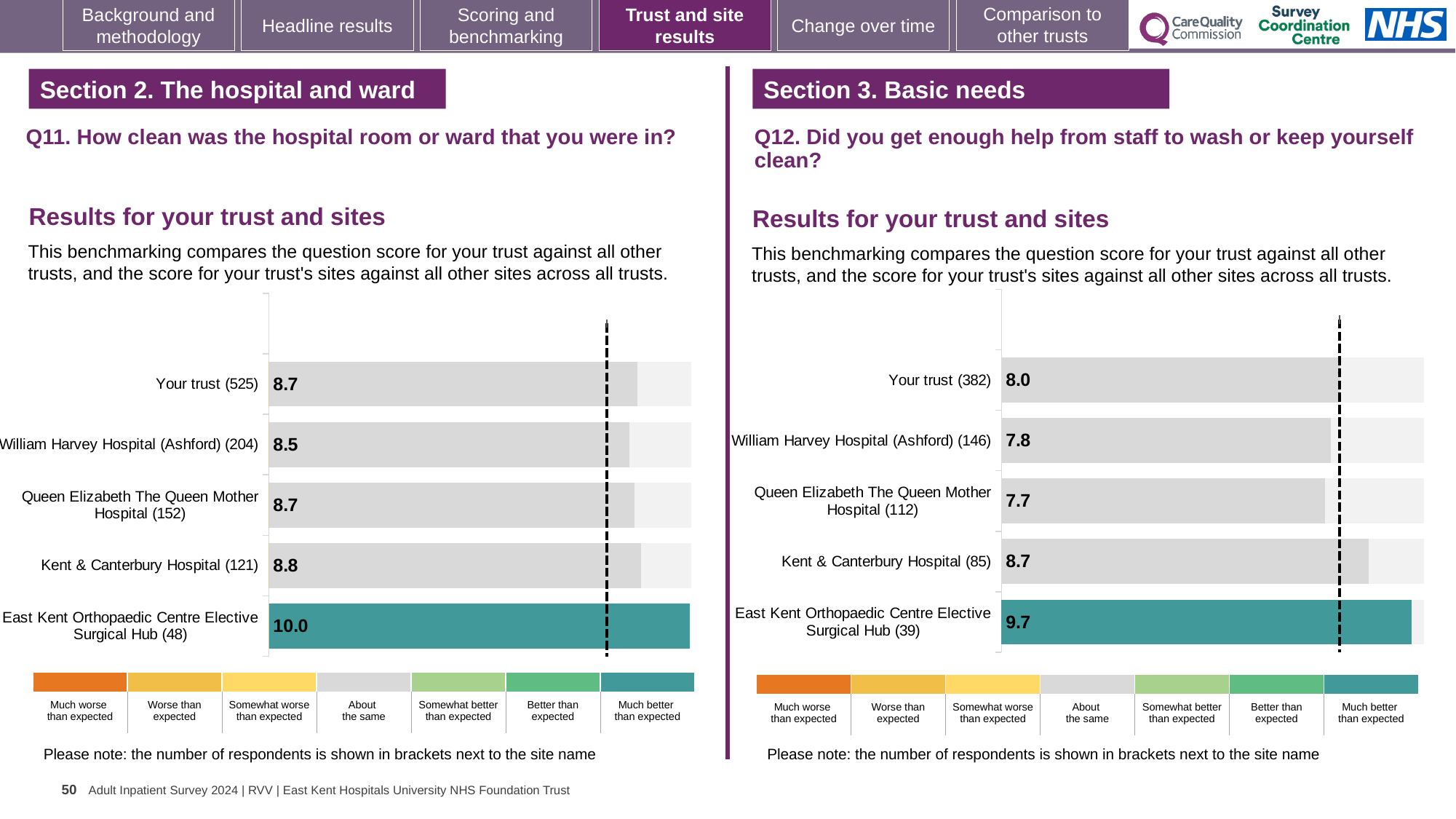
On the Q12 chart (right), which site has the highest score? East Kent Orthopaedic Centre Elective Surgical Hub On the Q12 chart (right), which is larger: the score for Your trust or the score for William Harvey Hospital (Ashford)? Your trust On the Q11 chart (left), what is the difference between the scores for East Kent Orthopaedic Centre Elective Surgical Hub and Kent & Canterbury Hospital? 1.2 On the Q12 chart (right), what is the score for Queen Elizabeth The Queen Mother Hospital? 7.7 On the Q11 chart (left), what is the score for Your trust? 8.7 On the Q12 chart (right), what is the difference between the scores for Your trust and Queen Elizabeth The Queen Mother Hospital? 0.3 On the Q11 chart (left), what is the score for East Kent Orthopaedic Centre Elective Surgical Hub? 10.0 On the Q11 chart (left), which site has the lowest score? William Harvey Hospital (Ashford) On the Q12 chart (right), what is the score for Kent & Canterbury Hospital? 8.7 What type of chart is used on the Q11 chart (left)? Bar chart On the Q11 chart (left), how many bars are plotted? 5 On the Q12 chart (right), how many respondents are shown in brackets for Your trust? 382